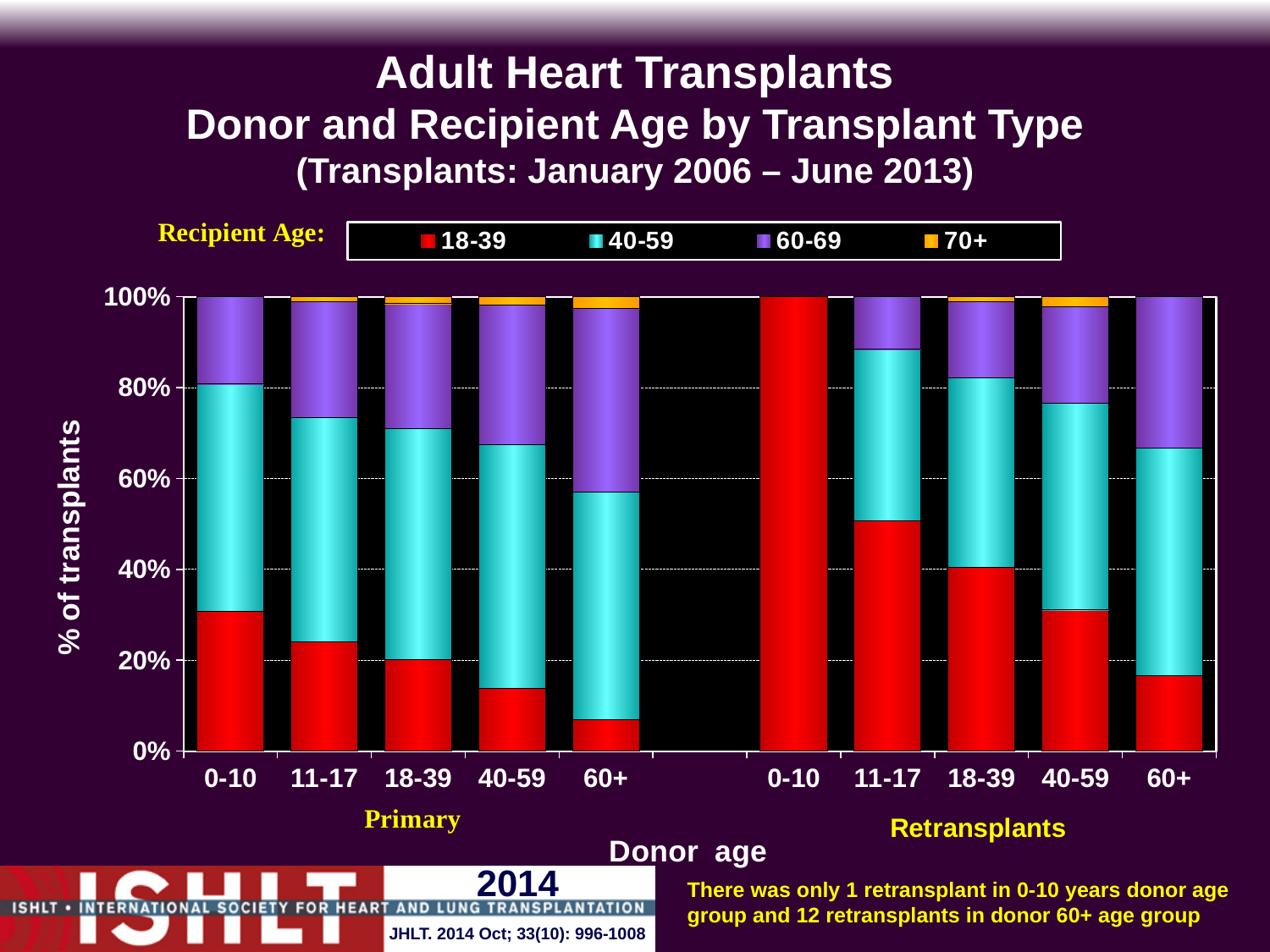
What kind of chart is shown on the slide? stacked bar chart Within the Primary group, which donor age category has the smallest 18-39 recipient age share? 60+ What is the label on the y axis of the chart? % of transplants What is the total of the stacked bar for the Primary 0-10 donor age group? 100% How many stacked bars are plotted in total across the Primary and Retransplants groups? 10 Within the Retransplants group, which donor age category has the largest 18-39 recipient age share? 0-10 Within the Primary group, does the 18-39 recipient age share rise or fall as donor age increases from 0-10 to 60+? fall Which has the larger 18-39 recipient age share: the Primary 0-10 bar or the Retransplants 0-10 bar? Retransplants 0-10 How many recipient age series does the legend list? 4 Is the 18-39 recipient age share for the Primary 0-10 donor age group greater or less than 20%? greater Is the 18-39 recipient age share for the Primary 60+ donor age group greater or less than 20%? less Is the 18-39 recipient age share for the Retransplants 0-10 donor age group greater or less than 80%? greater